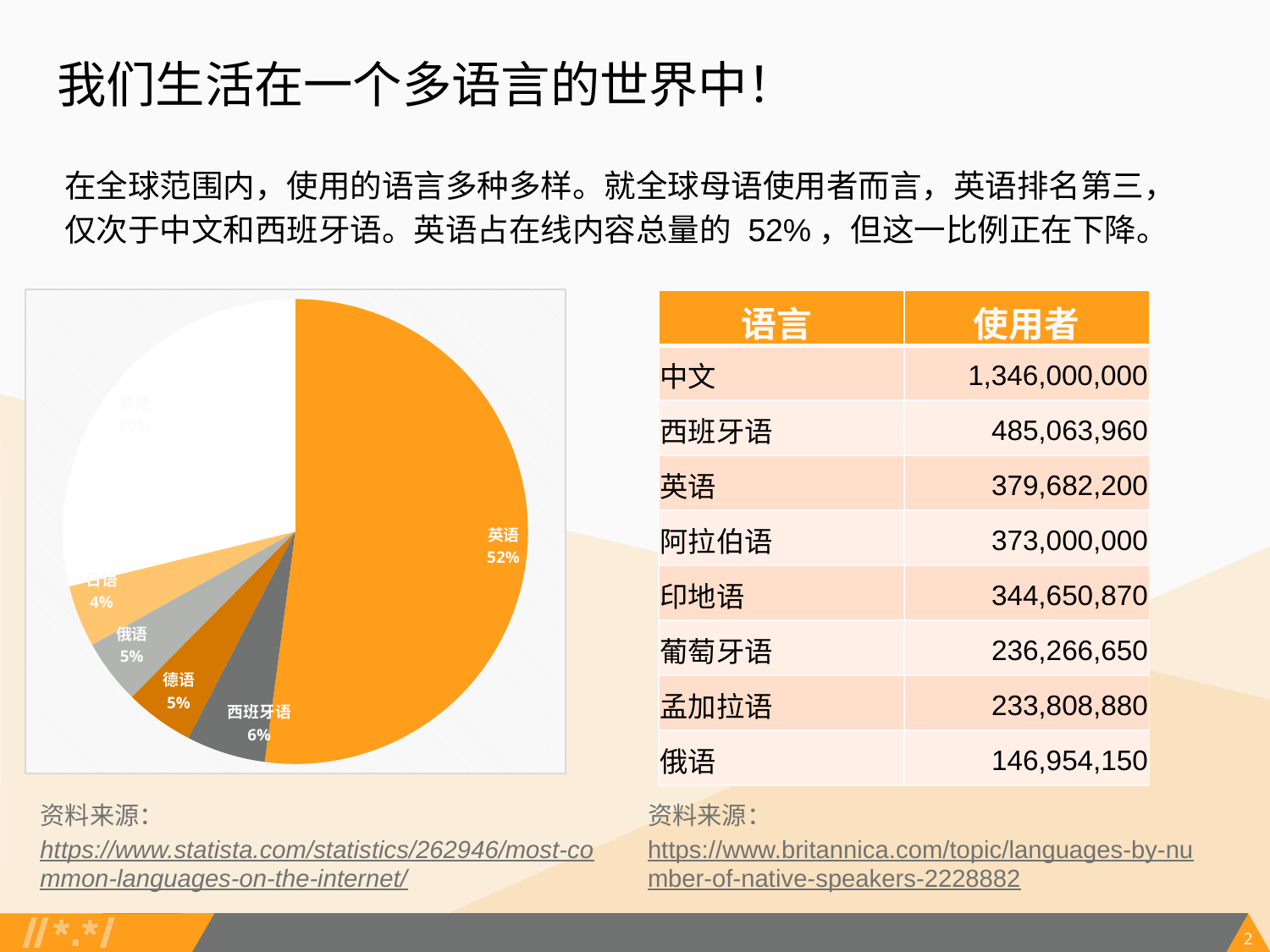
In the pie chart, what share is labelled for 俄语? 5% In the pie chart, what share is labelled for 西班牙语? 6% In the pie chart, how many percentage points larger is the 英语 share than the 西班牙语 share? 46% Which labelled slice of the pie chart is the smallest? 日语 What kind of chart is shown on the left of the slide? pie chart What colour is the 英语 slice in the pie chart? orange In the pie chart, what share is labelled for 日语? 4% How many slices does the pie chart have? 6 In the pie chart, which slice is larger, 西班牙语 or 日语? 西班牙语 Which slice of the pie chart is the largest? 英语 In the pie chart, what share is labelled for 英语? 52% In the pie chart, what share is labelled for 德语? 5%